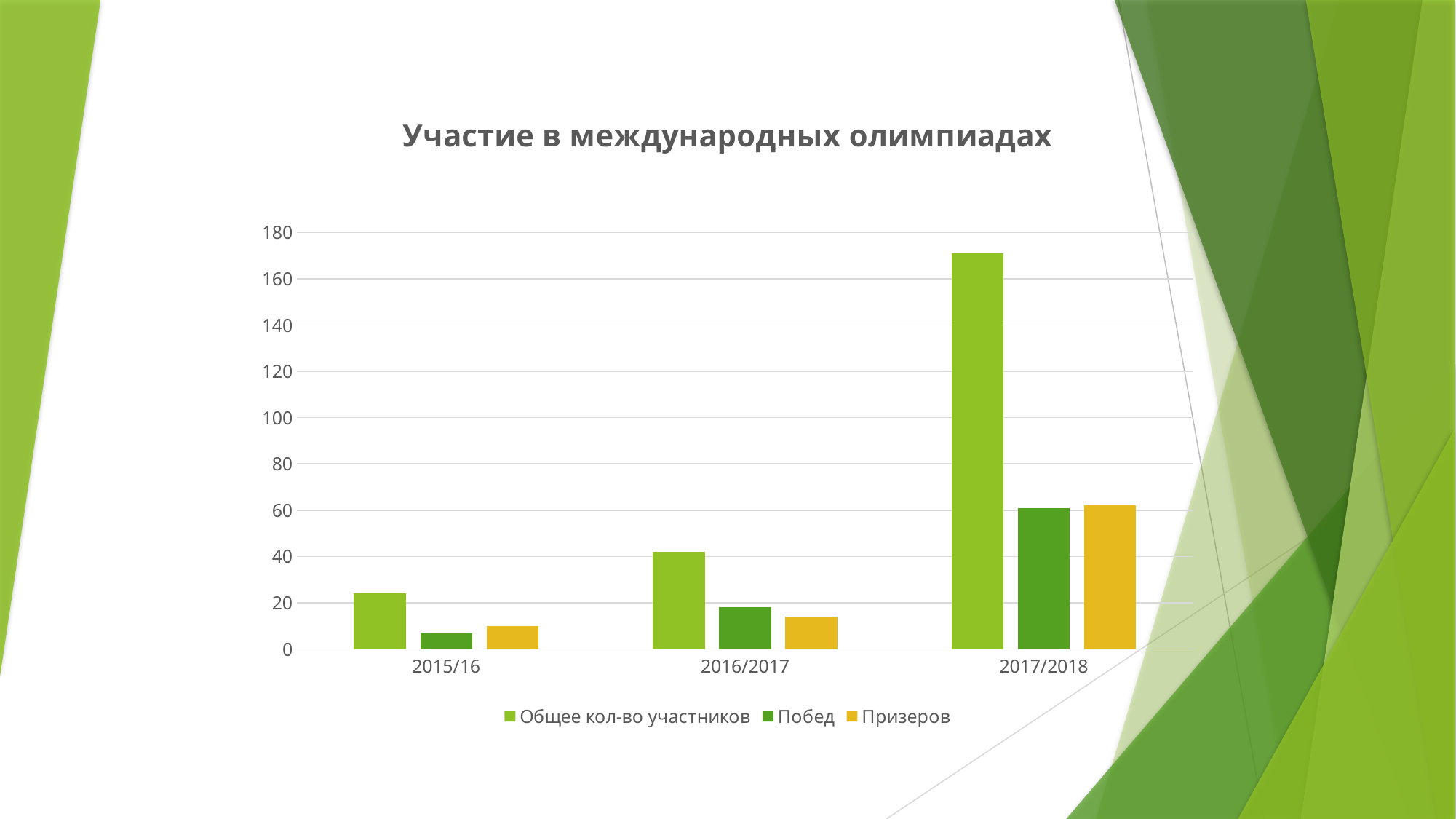
What kind of chart is shown on the slide? bar chart Which is larger: Общее кол-во участников in 2016/2017 or in 2015/16? 2016/2017 Is the value for Побед in 2017/2018 greater or less than 80? less How many series does the legend list? 3 Do the values for Общее кол-во участников rise or fall from 2015/16 to 2017/2018? rise How many academic years are shown on the x axis? 3 Is the value for Общее кол-во участников in 2017/2018 greater or less than 160? greater Is the value for Общее кол-во участников in 2015/16 greater or less than 40? less Which year has the highest value for Общее кол-во участников? 2017/2018 What is the title of the chart? Участие в международных олимпиадах Which year has the lowest value for Общее кол-во участников? 2015/16